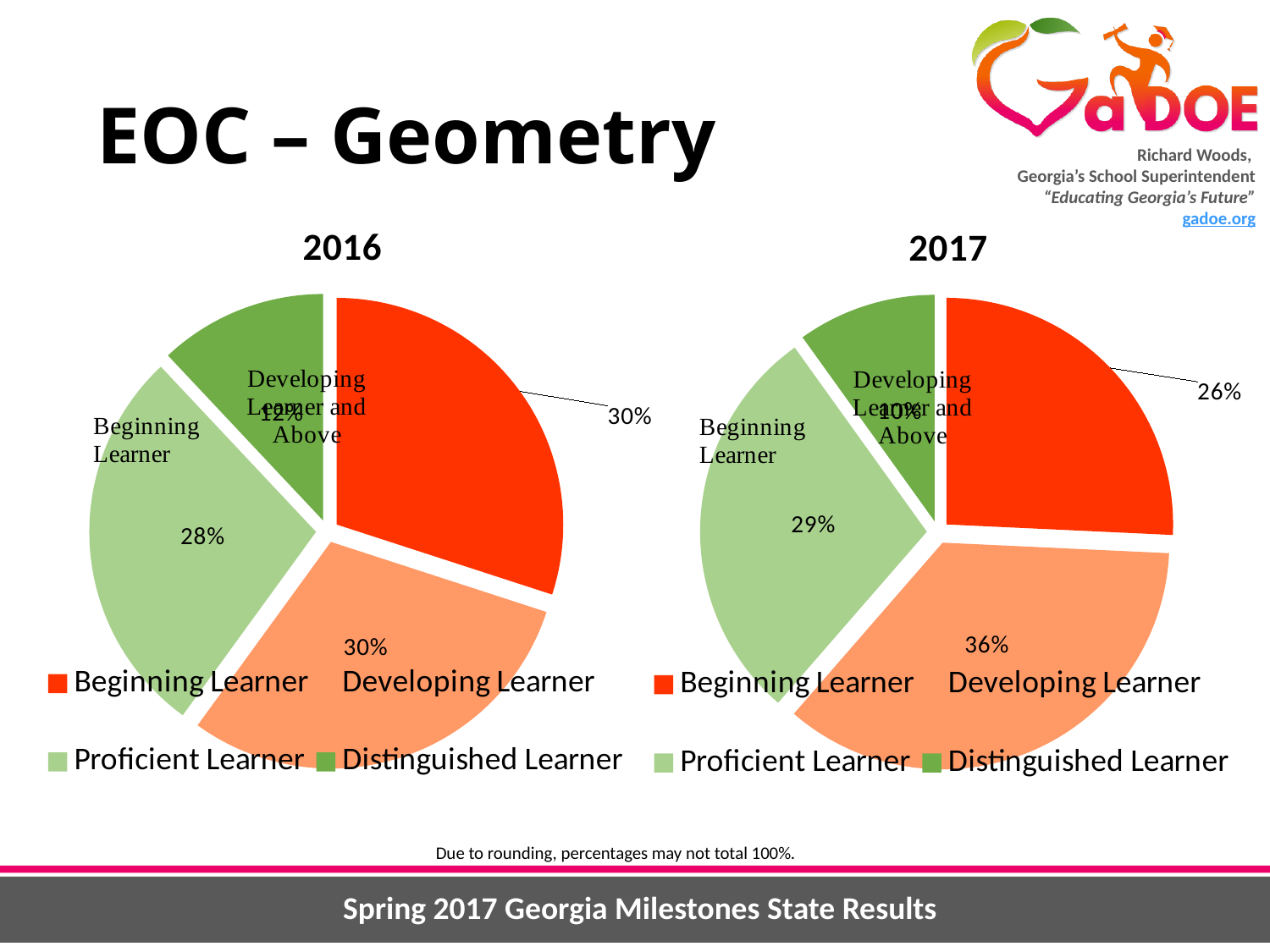
What is the difference between the Developing Learner percentage in the 2017 chart and in the 2016 chart? 6% In the 2017 pie chart, what percentage is shown for Developing Learner? 36% What type of chart is used to show the 2016 results? Pie chart In the 2016 pie chart, what percentage is shown for Developing Learner? 30% In the 2017 pie chart, what colour is the Beginning Learner slice? Red In the 2017 pie chart, what percentage is shown for Beginning Learner? 26% In the 2016 pie chart, which category has the smallest slice? Distinguished Learner In the 2016 pie chart, what percentage is shown for Proficient Learner? 28% In the 2017 pie chart, which category has the largest slice? Developing Learner How many categories does the legend of the 2016 pie chart list? 4 Is the Beginning Learner slice larger in the 2016 chart or the 2017 chart? 2016 In the 2017 pie chart, which category has the smallest slice? Distinguished Learner